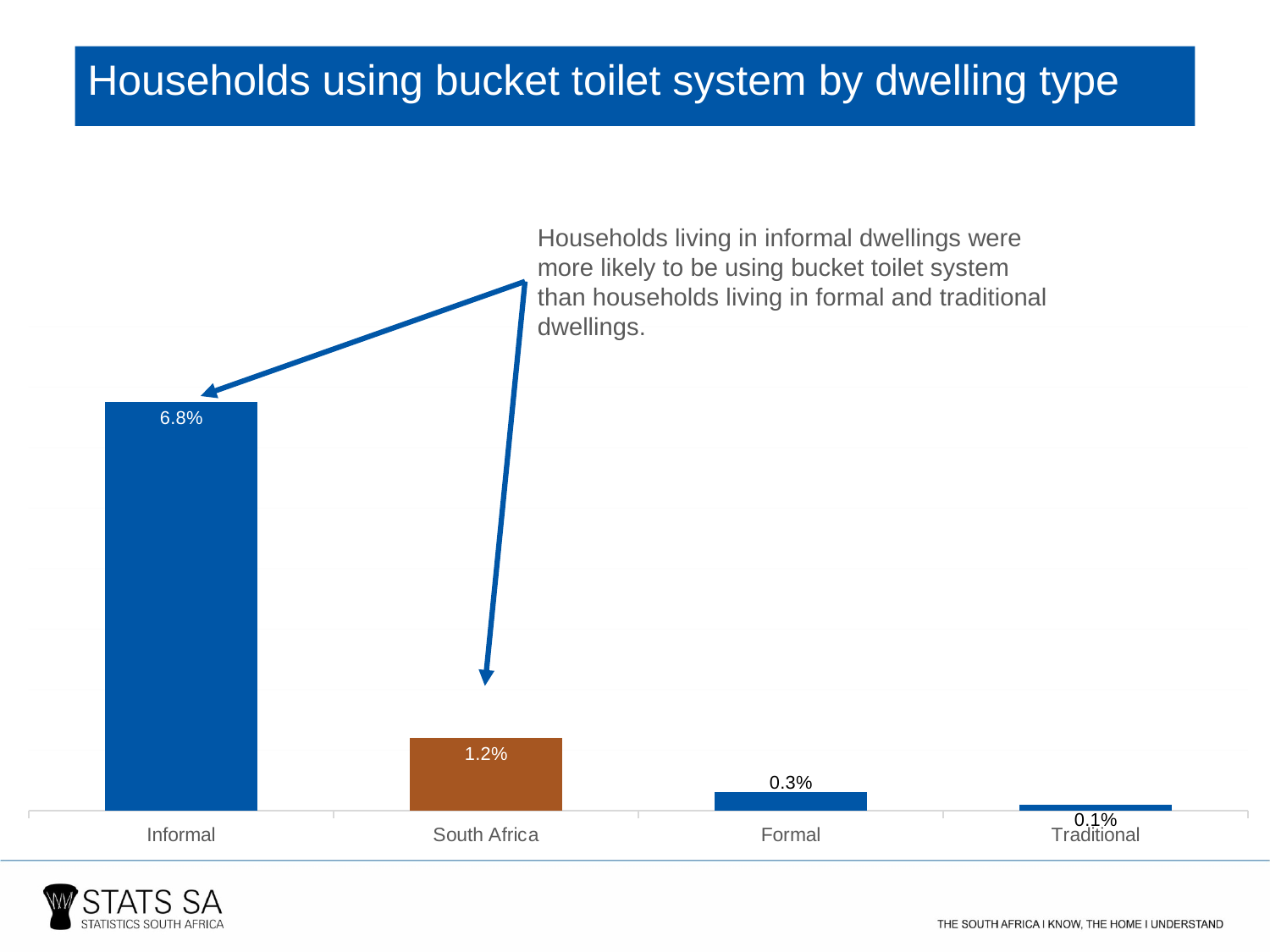
What kind of chart is shown on the slide? Bar chart What is the difference between the values for Formal and Traditional? 0.2 percentage points Which dwelling type has the highest share of households using a bucket toilet system? Informal Which bar is coloured differently (brown) from the others? South Africa What is the difference between the values for Informal and South Africa? 5.6 percentage points How many categories are shown on the chart? 4 What is the value for traditional dwellings? 0.1% What is the value shown for South Africa? 1.2% What percentage of households in informal dwellings use a bucket toilet system? 6.8% Which is larger, the value for Formal or the value for South Africa? South Africa What percentage is shown for formal dwellings? 0.3% Which category has the lowest value on the chart? Traditional